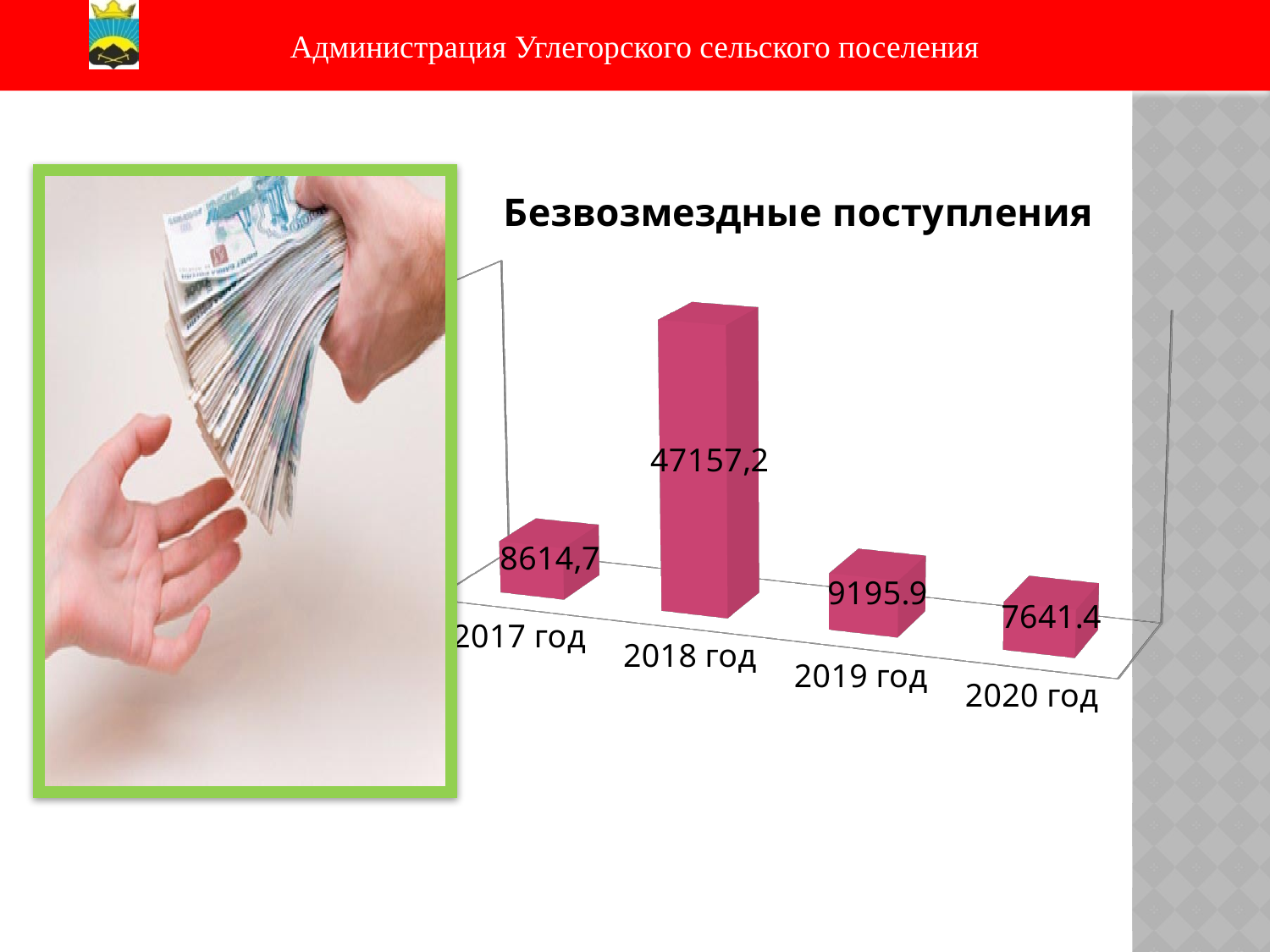
Which year has the highest value in the chart? 2018 год What is the title of the chart? Безвозмездные поступления Which year has the lowest value in the chart? 2020 год What is the difference between the values for 2019 год and 2020 год? 1554.5 How many years are shown in the chart? 4 What is the value for 2020 год in the chart? 7641.4 What is the value for 2019 год in the chart? 9195.9 Which is larger, the value for 2019 год or the value for 2017 год? 2019 год What is the value for 2017 год in the chart? 8614,7 What is the difference between the values for 2018 год and 2017 год? 38542,5 What kind of chart is shown on the slide? Bar chart What is the value for 2018 год in the chart? 47157,2